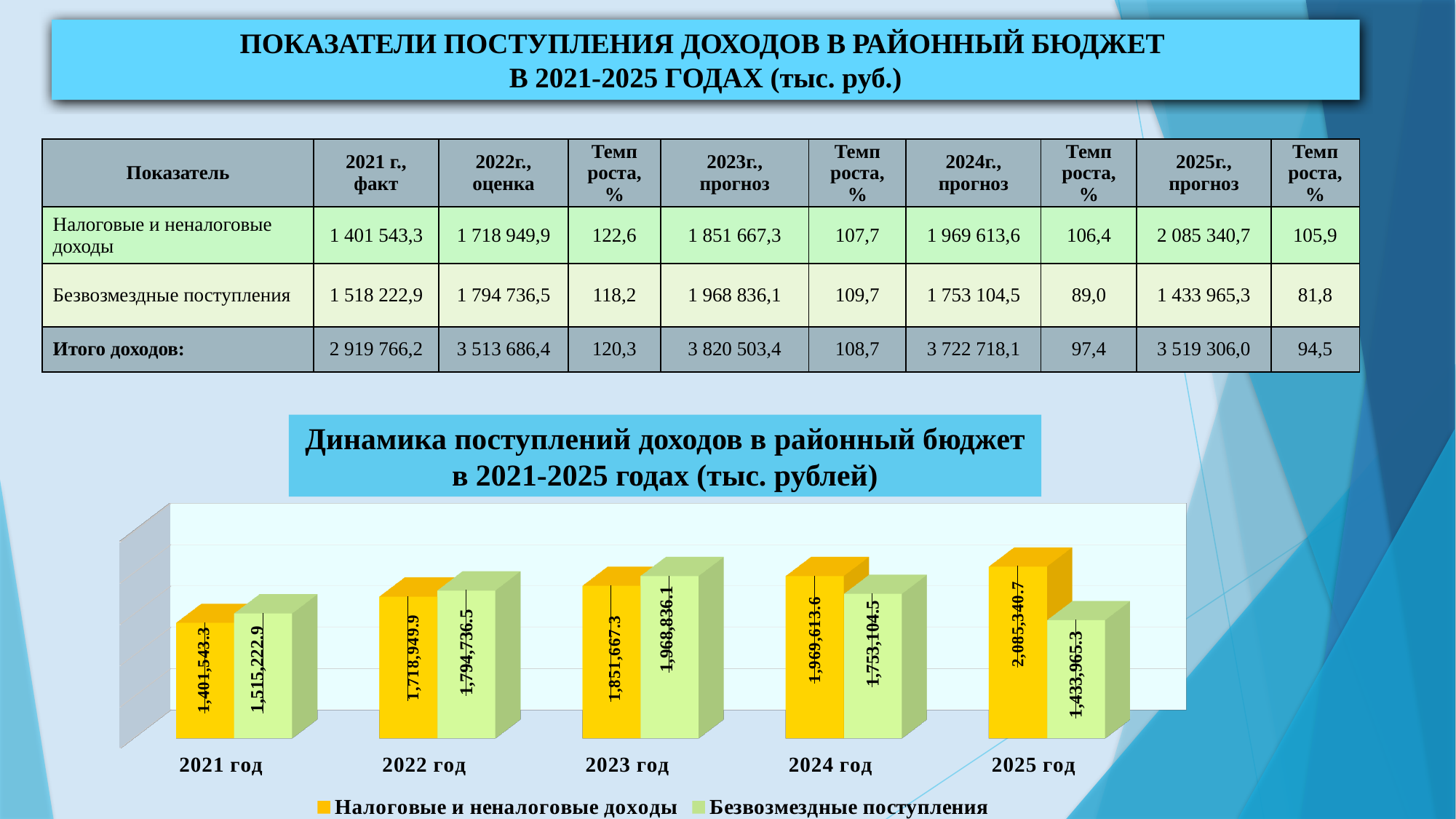
In which year is Безвозмездные поступления lowest in the chart? 2025 год In which year is Налоговые и неналоговые доходы highest in the chart? 2025 год How many years are shown on the x axis of the chart? 5 What kind of chart is shown on the slide? bar chart What is the value of Налоговые и неналоговые доходы for 2021 год in the chart? 1,401,543.3 How many series does the chart legend list? 2 What is the value of Безвозмездные поступления for 2025 год in the chart? 1,433,965.3 In the chart, what is the difference between Налоговые и неналоговые доходы and Безвозмездные поступления for 2025 год? 651,375.4 In which year is Безвозмездные поступления highest in the chart? 2023 год In the chart, which is larger for 2024 год: Налоговые и неналоговые доходы or Безвозмездные поступления? Налоговые и неналоговые доходы What is the value of Безвозмездные поступления for 2023 год in the chart? 1,968,836.1 Does Налоговые и неналоговые доходы rise or fall from 2021 год to 2025 год in the chart? rise